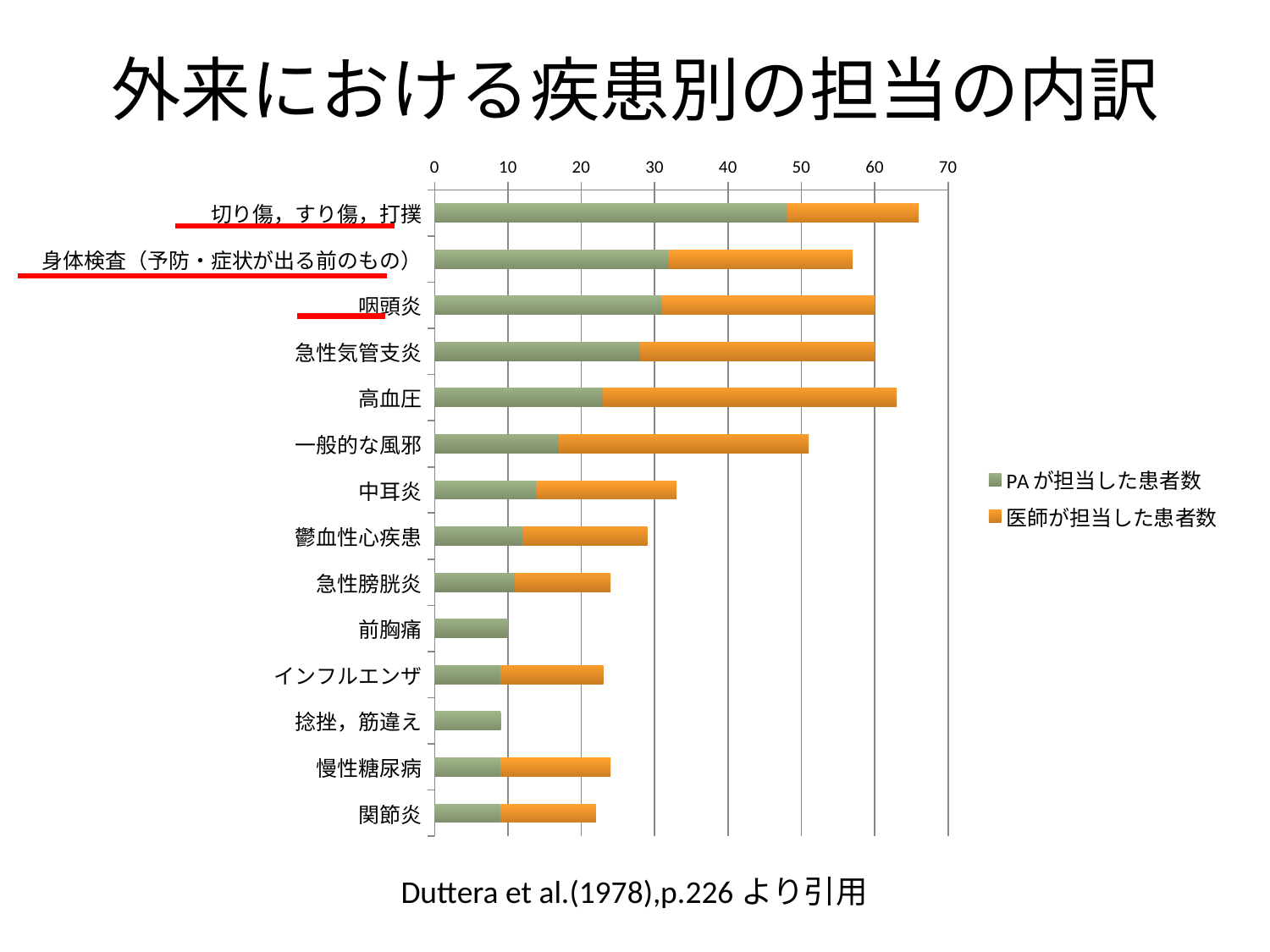
Is the total bar length for 関節炎 greater or less than 20? greater Is the total bar length for 高血圧 greater or less than 60? greater What kind of chart is shown on the slide? Stacked bar chart What is the title of the slide containing the chart? 外来における疾患別の担当の内訳 Which has the larger 医師が担当した患者数 segment: 高血圧 or 一般的な風邪? 高血圧 Is the PA が担当した患者数 value for 切り傷，すり傷，打撲 greater or less than 40? greater How many disease categories are plotted on the chart? 14 Which has the larger PA が担当した患者数 value: 切り傷，すり傷，打撲 or 身体検査（予防・症状が出る前のもの）? 切り傷，すり傷，打撲 What are the two series named in the legend? PA が担当した患者数, 医師が担当した患者数 How many series does the legend list? 2